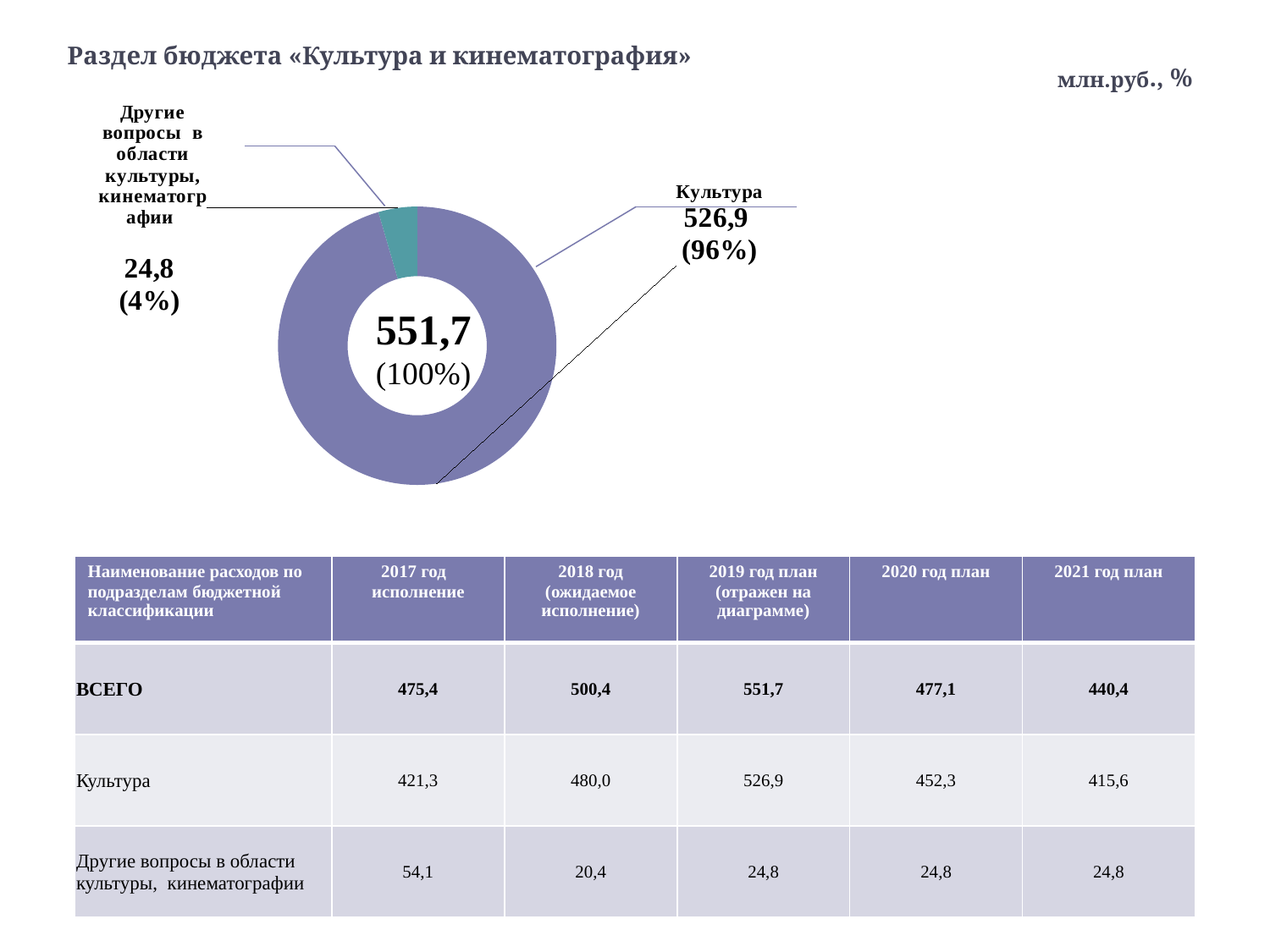
Which is larger on the chart: "Культура" or "Другие вопросы в области культуры, кинематографии"? Культура What is the value shown for the "Другие вопросы в области культуры, кинематографии" slice? 24,8 What total value is shown in the centre of the doughnut chart? 551,7 What share of the doughnut does the "Другие вопросы в области культуры, кинематографии" slice represent? 4% What units are indicated for the chart in the top right of the slide? млн.руб., % How many slices does the doughnut chart have? 2 What share of the doughnut does the "Культура" slice represent? 96% Which slice of the doughnut chart is the largest? Культура What is the value shown for the "Культура" slice? 526,9 What kind of chart is shown on the slide? Doughnut (pie) chart What is the difference between the "Культура" value and the "Другие вопросы в области культуры, кинематографии" value on the chart? 502,1 Which slice of the doughnut chart is the smallest? Другие вопросы в области культуры, кинематографии